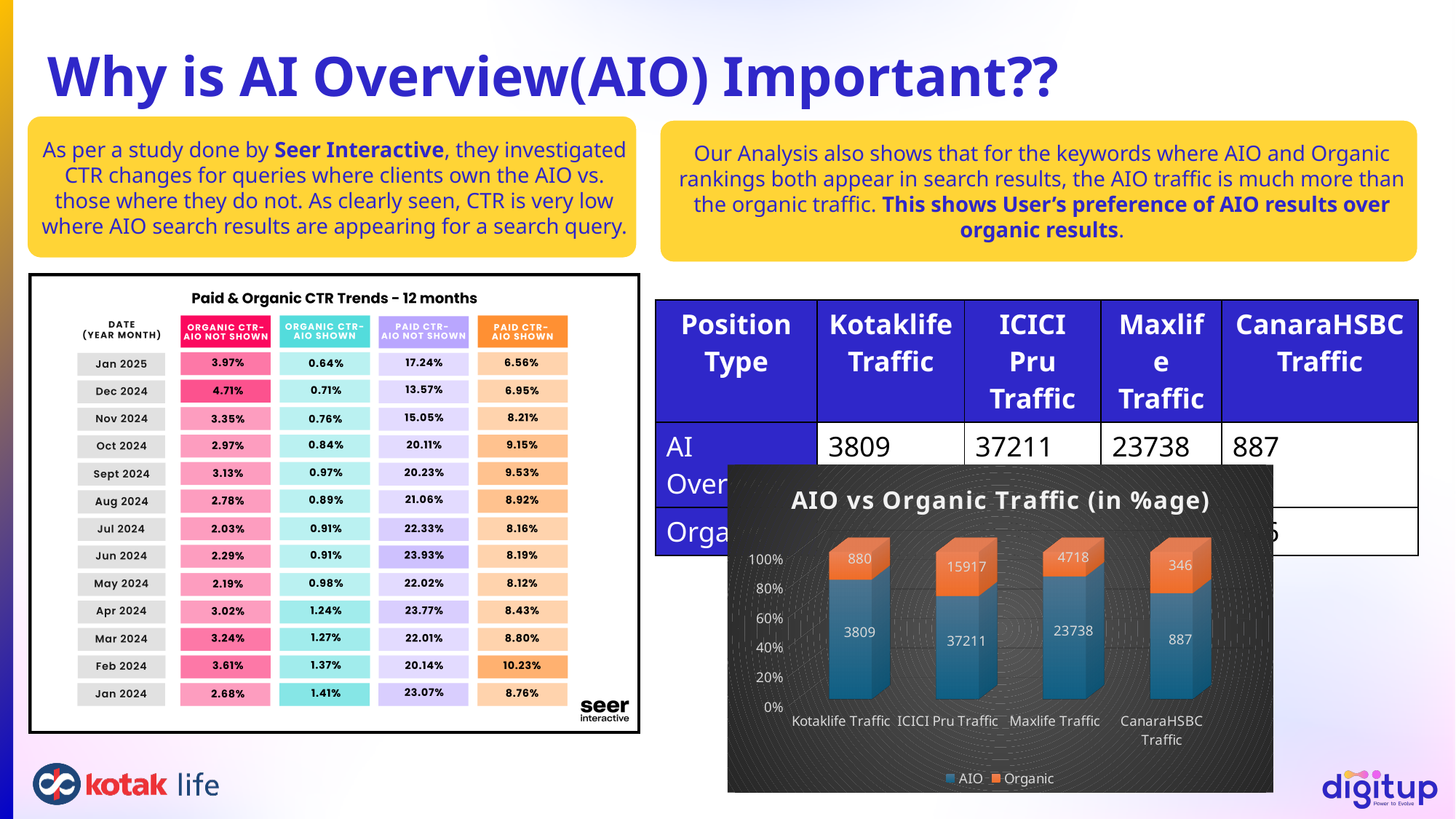
In the 'AIO vs Organic Traffic (in %age)' chart, what is the AIO value for CanaraHSBC Traffic? 887 In the 'AIO vs Organic Traffic (in %age)' chart, which is larger for Maxlife Traffic: the AIO value or the Organic value? AIO In the 'AIO vs Organic Traffic (in %age)' chart, what is the difference between the AIO and Organic values for ICICI Pru Traffic? 21294 In the 'AIO vs Organic Traffic (in %age)' chart, what is the total of the AIO and Organic values for Kotaklife Traffic? 4689 How many series does the legend of the 'AIO vs Organic Traffic (in %age)' chart list? 2 In the 'AIO vs Organic Traffic (in %age)' chart, which category has the highest AIO value? ICICI Pru Traffic In the 'AIO vs Organic Traffic (in %age)' chart, what is the AIO value for ICICI Pru Traffic? 37211 What kind of chart is 'AIO vs Organic Traffic (in %age)'? Stacked bar chart In the 'AIO vs Organic Traffic (in %age)' chart, what is the Organic value for Kotaklife Traffic? 880 In the 'AIO vs Organic Traffic (in %age)' chart, what is the Organic value for Maxlife Traffic? 4718 In the 'AIO vs Organic Traffic (in %age)' chart, which category has the lowest Organic value? CanaraHSBC Traffic How many categories are shown on the x axis of the 'AIO vs Organic Traffic (in %age)' chart? 4